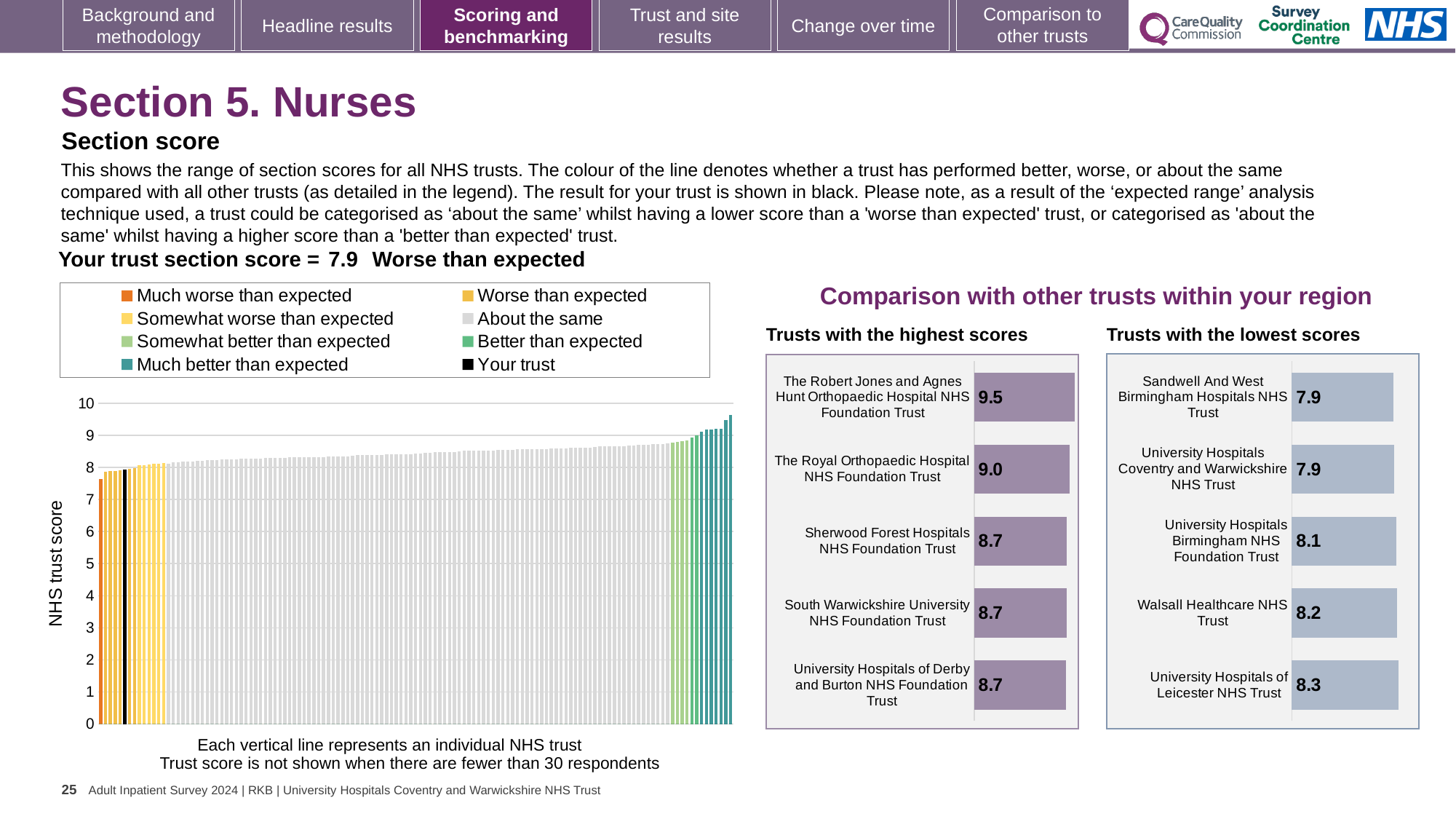
In the 'Trusts with the highest scores' chart, which trust has the highest score? The Robert Jones and Agnes Hunt Orthopaedic Hospital NHS Foundation Trust In the 'Trusts with the lowest scores' chart, what is the difference between the scores of University Hospitals of Leicester NHS Trust and Sandwell And West Birmingham Hospitals NHS Trust? 0.4 In the 'Trusts with the highest scores' chart, what is the score for The Royal Orthopaedic Hospital NHS Foundation Trust? 9.0 In the 'NHS trust score' chart on the left, do the trust scores rise or fall from left to right? rise How many trusts are shown in the 'Trusts with the highest scores' chart? 5 In the 'Trusts with the lowest scores' chart, which trust has the highest score shown? University Hospitals of Leicester NHS Trust In the 'Trusts with the lowest scores' chart, what is the score for University Hospitals of Leicester NHS Trust? 8.3 In the 'Trusts with the lowest scores' chart, what is the score for Walsall Healthcare NHS Trust? 8.2 Which is larger: the score for University Hospitals Birmingham NHS Foundation Trust in the 'Trusts with the lowest scores' chart or the score for Sherwood Forest Hospitals NHS Foundation Trust in the 'Trusts with the highest scores' chart? Sherwood Forest Hospitals NHS Foundation Trust In the 'Trusts with the highest scores' chart, what is the score for The Robert Jones and Agnes Hunt Orthopaedic Hospital NHS Foundation Trust? 9.5 In the 'Trusts with the highest scores' chart, what is the difference between the scores of The Robert Jones and Agnes Hunt Orthopaedic Hospital NHS Foundation Trust and The Royal Orthopaedic Hospital NHS Foundation Trust? 0.5 How many entries does the legend of the 'NHS trust score' chart on the left list? 8